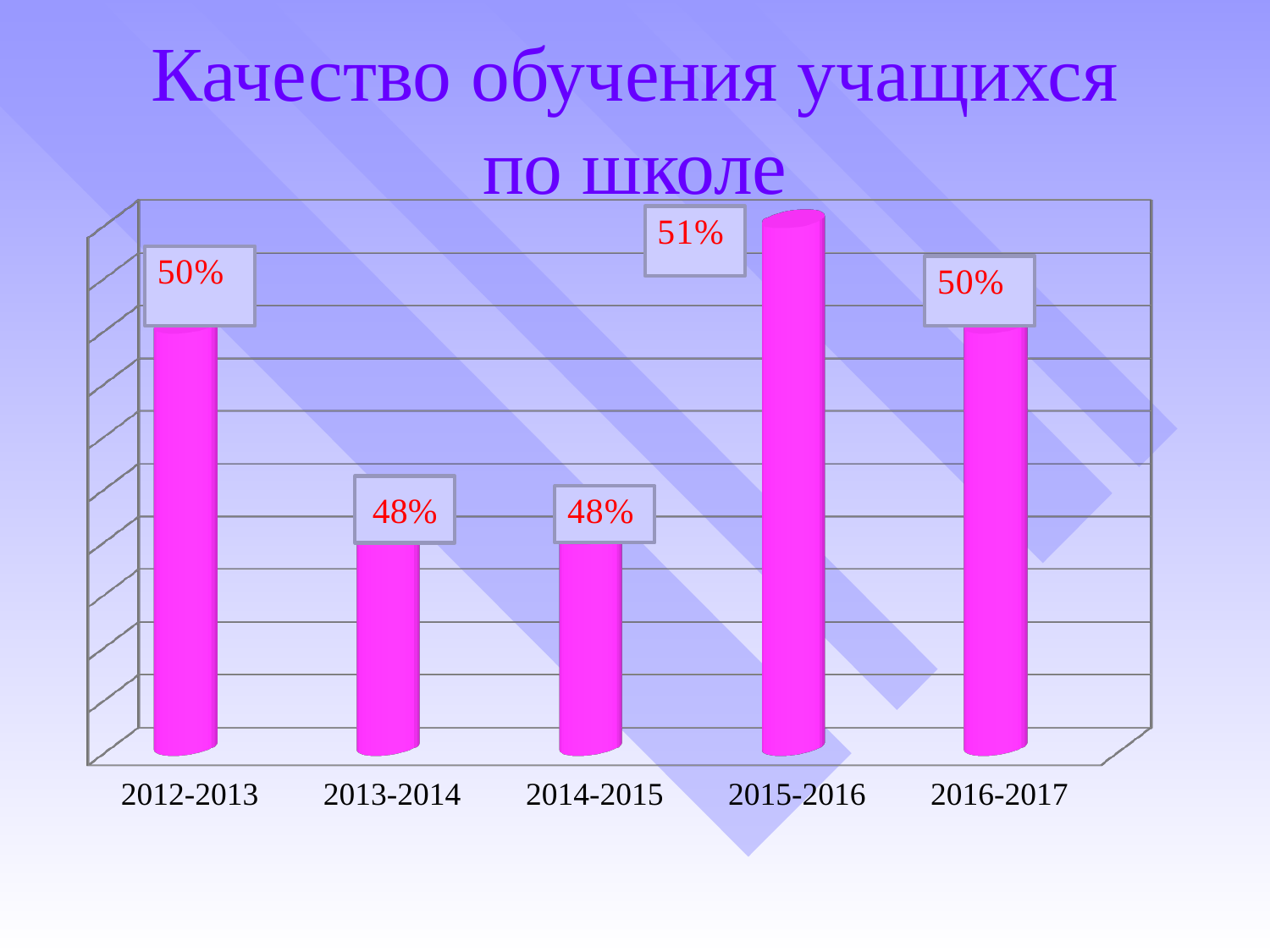
Which is larger, the value for 2012-2013 or the value for 2013-2014? 2012-2013 What is the value for 2012-2013? 50% What is the value for 2016-2017? 50% What is the value for 2014-2015? 48% What is the value for 2015-2016? 51% What kind of chart is shown on the slide? Bar chart Which school year has the highest value? 2015-2016 What is the title of the chart? Качество обучения учащихся по школе Do the values rise or fall from 2014-2015 to 2015-2016? Rise How many school years are shown on the chart? 5 What is the difference between the values for 2015-2016 and 2013-2014? 3% Which school years have the lowest value? 2013-2014 and 2014-2015